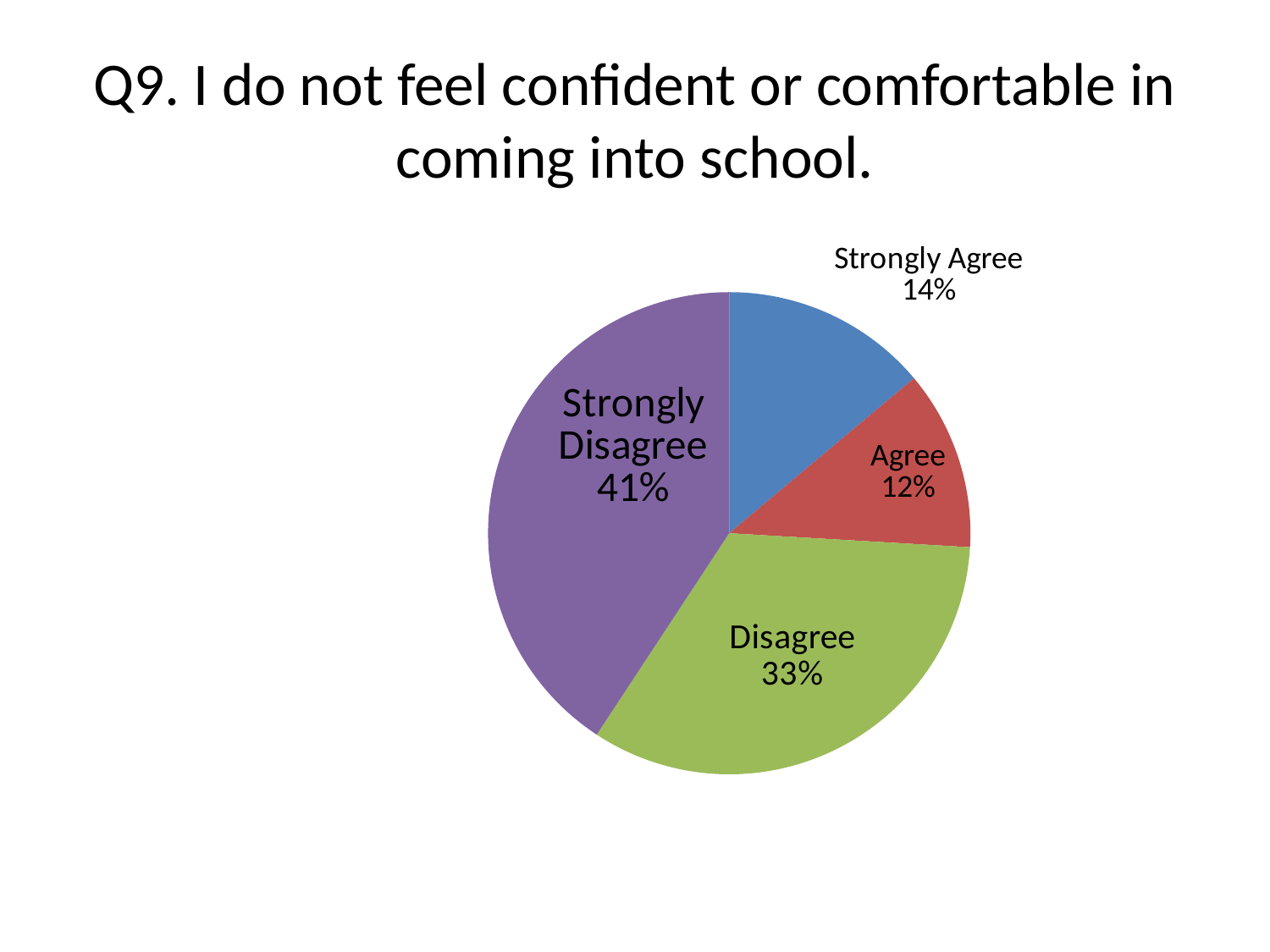
What percentage of respondents chose Disagree? 33% What kind of chart is shown on the slide? pie chart What percentage of respondents chose Strongly Disagree? 41% What is the title of the chart on the slide? Q9. I do not feel confident or comfortable in coming into school. How many slices does the pie chart have? 4 What is the difference in percentage points between Strongly Disagree and Disagree? 8 Which response has the largest share of the pie? Strongly Disagree What is the combined share of Disagree and Strongly Disagree? 74% What percentage of respondents chose Strongly Agree? 14% Which response has the smallest share of the pie? Agree What percentage of respondents chose Agree? 12% Which is larger, the share for Strongly Agree or the share for Agree? Strongly Agree